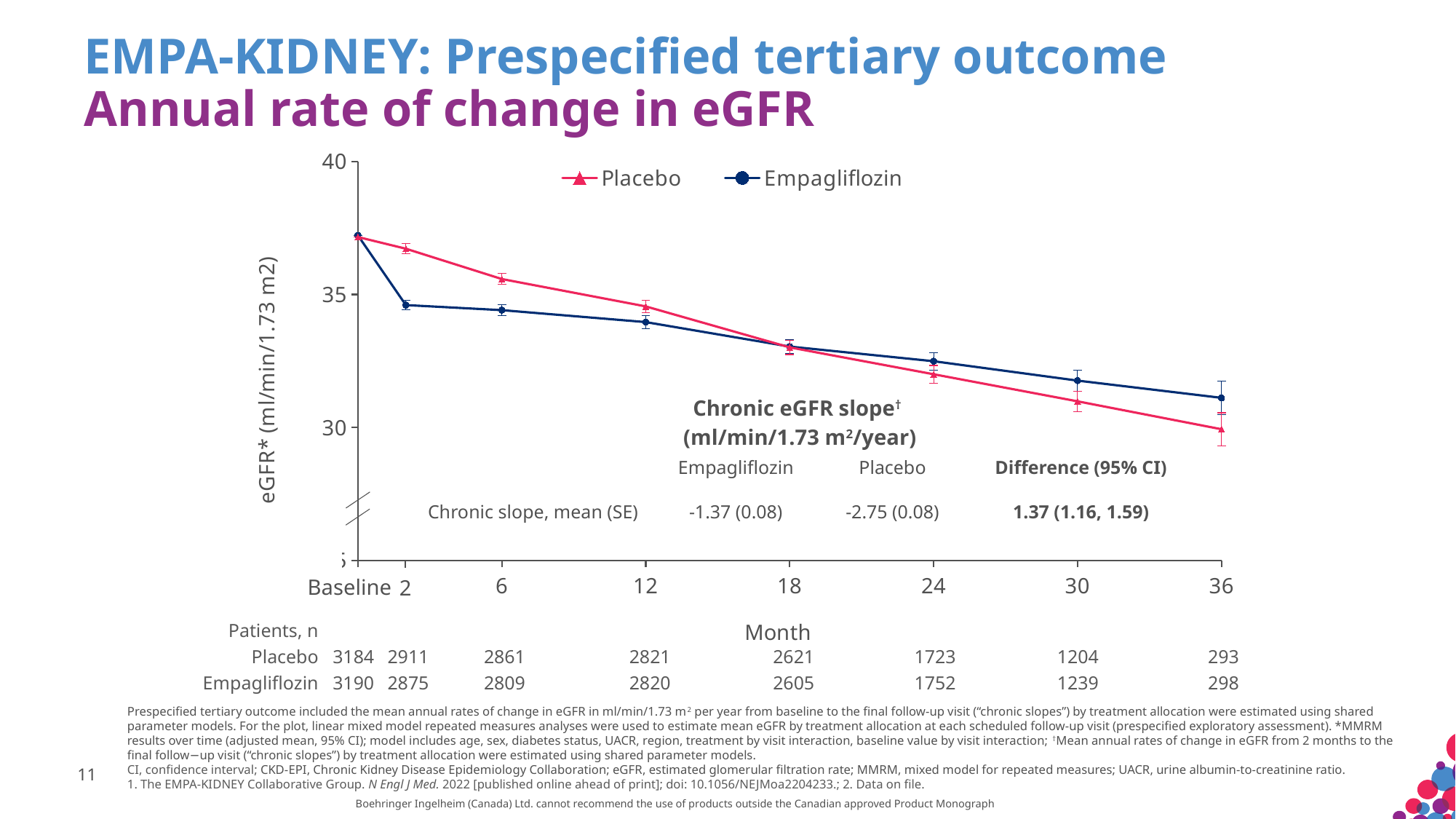
What is the chronic eGFR slope, mean (SE), for Placebo? -2.75 (0.08) What is the difference (95% CI) in chronic eGFR slope between Empagliflozin and Placebo? 1.37 (1.16, 1.59) What kind of chart is shown on the slide? line chart What is the chronic eGFR slope, mean (SE), for Empagliflozin? -1.37 (0.08) What is the label on the y axis of the chart? eGFR* (ml/min/1.73 m2) At month 36, which series has the higher eGFR value, Placebo or Empagliflozin? Empagliflozin Is the eGFR value for Empagliflozin at month 2 greater or less than 35? less How many time points are plotted along the x axis (including Baseline)? 8 Is the eGFR value for Empagliflozin at month 36 greater or less than 30? greater At month 6, which series has the higher eGFR value, Placebo or Empagliflozin? Placebo Do the eGFR values for Placebo rise or fall from Baseline to month 36? fall How many series does the legend list? 2